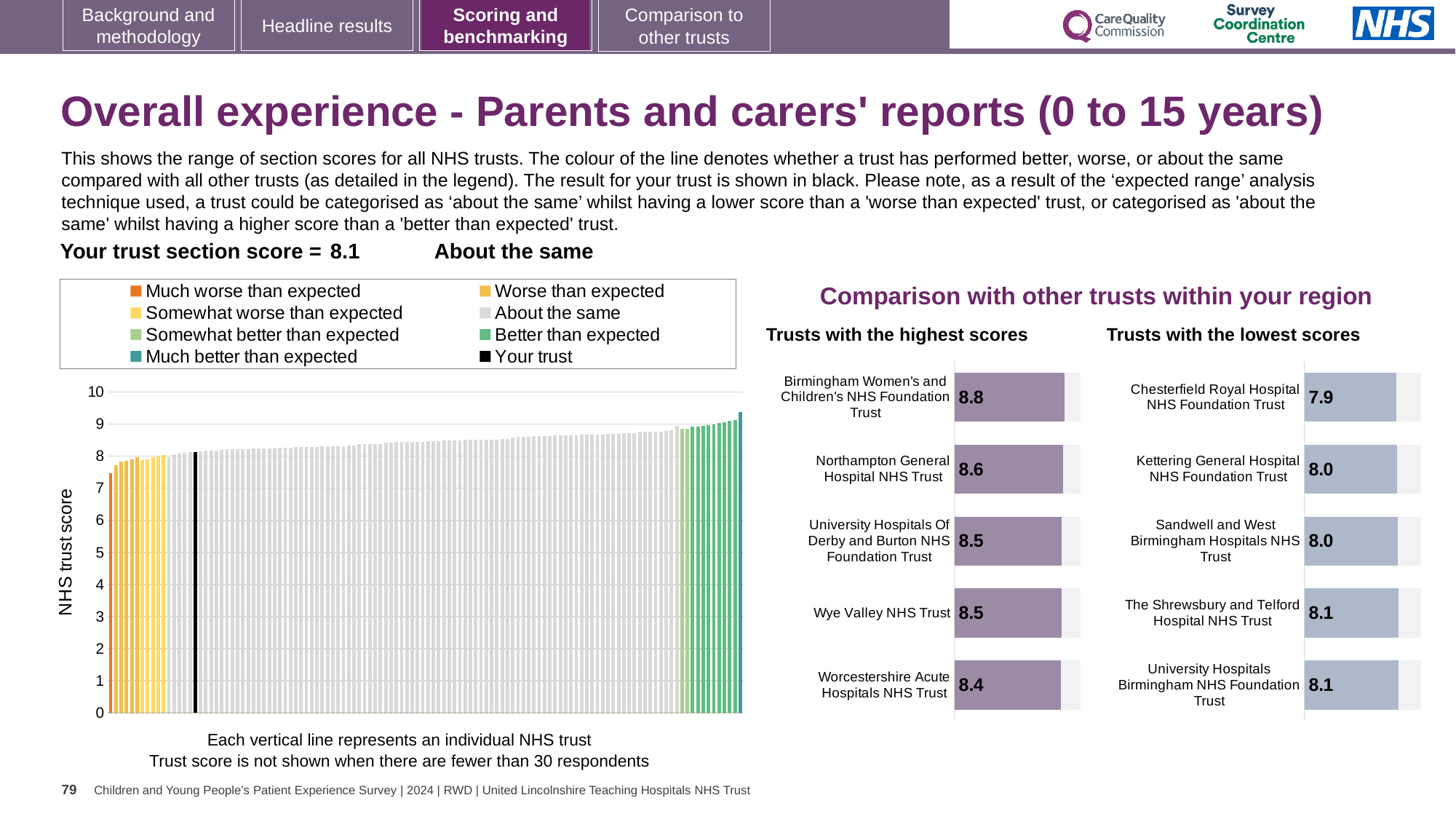
In the 'Trusts with the lowest scores' chart, which has the larger score: Kettering General Hospital NHS Foundation Trust or The Shrewsbury and Telford Hospital NHS Trust? The Shrewsbury and Telford Hospital NHS Trust How many entries does the legend above the large chart on the left list? 8 In the large chart on the left, what is the label on the vertical axis? NHS trust score In the 'Trusts with the highest scores' chart, what is the score for Northampton General Hospital NHS Trust? 8.6 What kind of chart is the large chart on the left showing NHS trust scores? bar chart How many trusts are shown in the 'Trusts with the lowest scores' chart? 5 In the large chart on the left, is the value of the black bar (your trust) greater or less than 5? greater In the 'Trusts with the highest scores' chart, which trust has the highest score? Birmingham Women's and Children's NHS Foundation Trust In the large chart on the left, is the value of the lowest (leftmost) bar greater or less than 8? less In the large chart on the left, is the value of the highest (rightmost) bar greater or less than 9? greater In the 'Trusts with the highest scores' chart, what is the difference between the scores of Birmingham Women's and Children's NHS Foundation Trust and Worcestershire Acute Hospitals NHS Trust? 0.4 In the 'Trusts with the lowest scores' chart, which trust has the lowest score? Chesterfield Royal Hospital NHS Foundation Trust